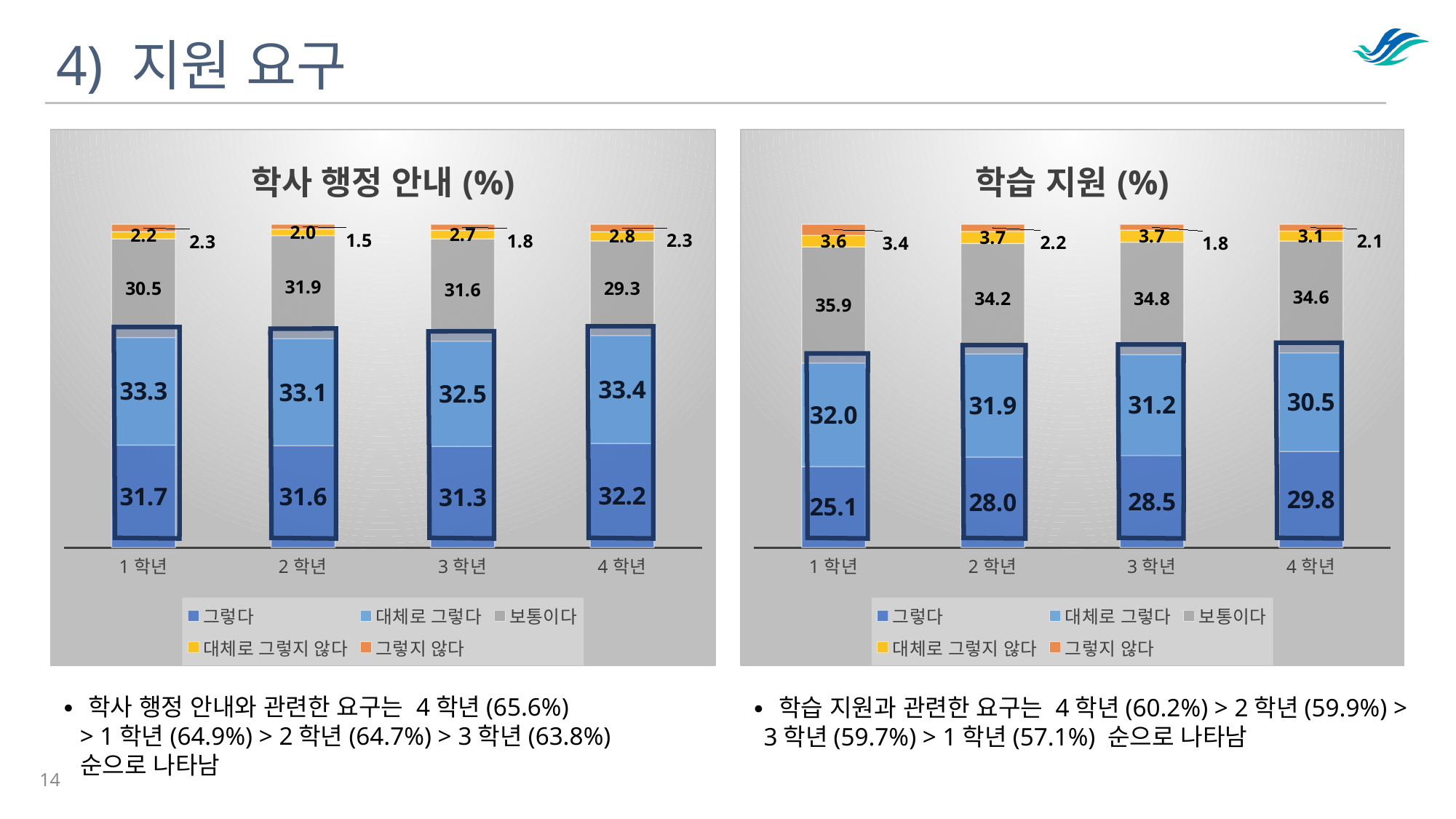
In the 학사 행정 안내 (%) chart, which grade has the highest 보통이다 value? 2 학년 In the 학사 행정 안내 (%) chart, what is the 그렇지 않다 value for 2 학년? 1.5 In the 학사 행정 안내 (%) chart, which is larger: the 대체로 그렇다 value for 1 학년 or for 3 학년? 1 학년 In the 학사 행정 안내 (%) chart, what is the 그렇다 value for 4 학년? 32.2 In the 학습 지원 (%) chart, what is the 보통이다 value for 1 학년? 35.9 What type of chart is the 학습 지원 (%) chart? Stacked bar chart In the 학습 지원 (%) chart, what is the total of the stacked bar for 1 학년? 100.0 How many series does the legend of the 학사 행정 안내 (%) chart list? 5 What is the title of the chart on the right side of the slide? 학습 지원 (%) In the 학습 지원 (%) chart, which grade has the lowest 그렇다 value? 1 학년 In the 학습 지원 (%) chart, what is the difference between the 그렇다 values for 4 학년 and 1 학년? 4.7 How many grade categories are shown on the x axis of the 학습 지원 (%) chart? 4